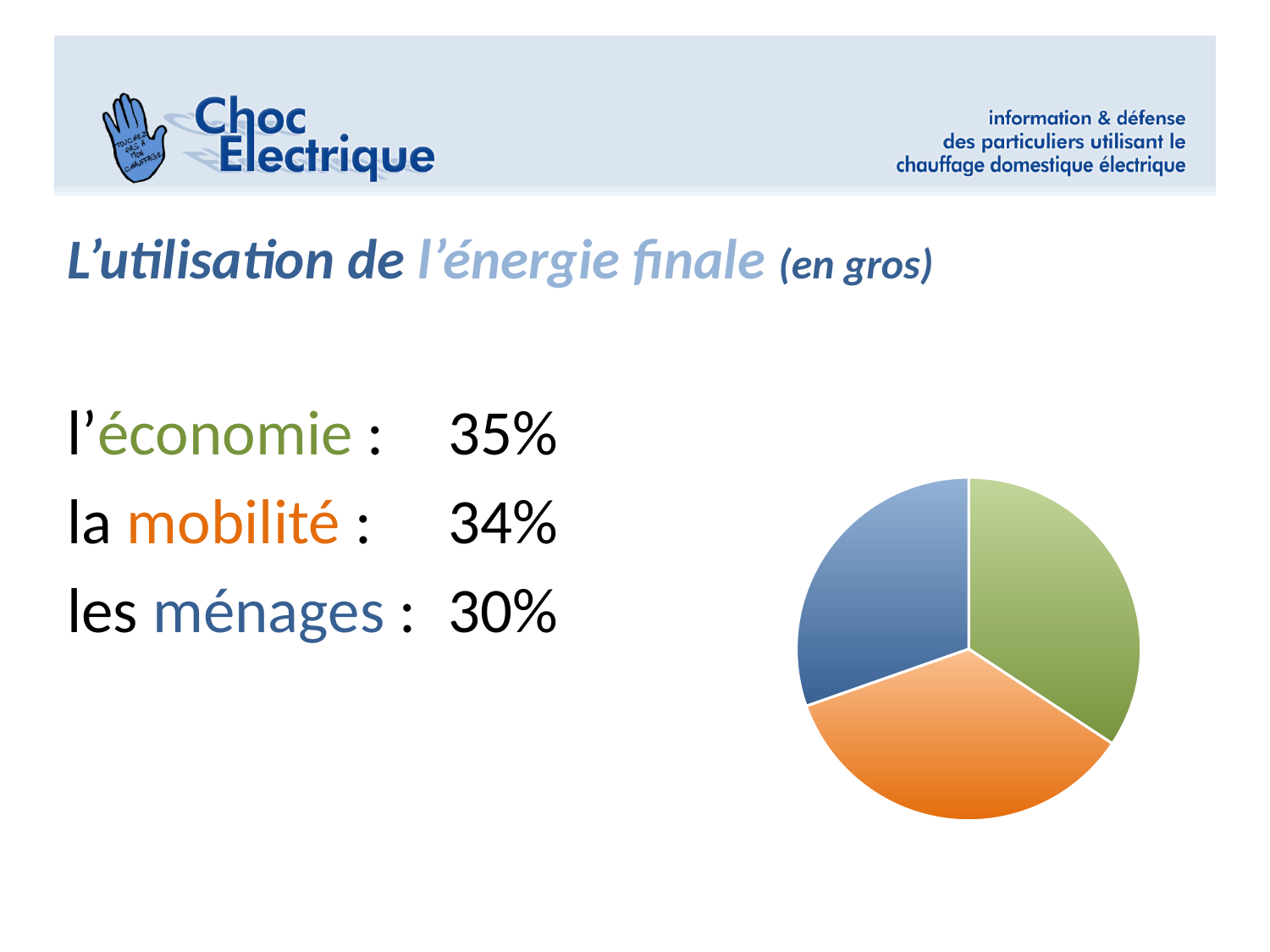
Which category has the largest share of final energy use? l'économie Which is larger, the share for la mobilité or the share for les ménages? la mobilité What is the difference in percentage points between l'économie and les ménages? 5 What is the title of the slide? L'utilisation de l'énergie finale (en gros) What is the difference in percentage points between la mobilité and les ménages? 4 Which category has the smallest share of final energy use? les ménages What share of final energy use goes to les ménages? 30% What colour is the slice representing la mobilité? orange What kind of chart is shown on the slide? pie chart How many categories does the pie chart show? 3 What share of final energy use goes to la mobilité? 34% What share of final energy use goes to l'économie? 35%